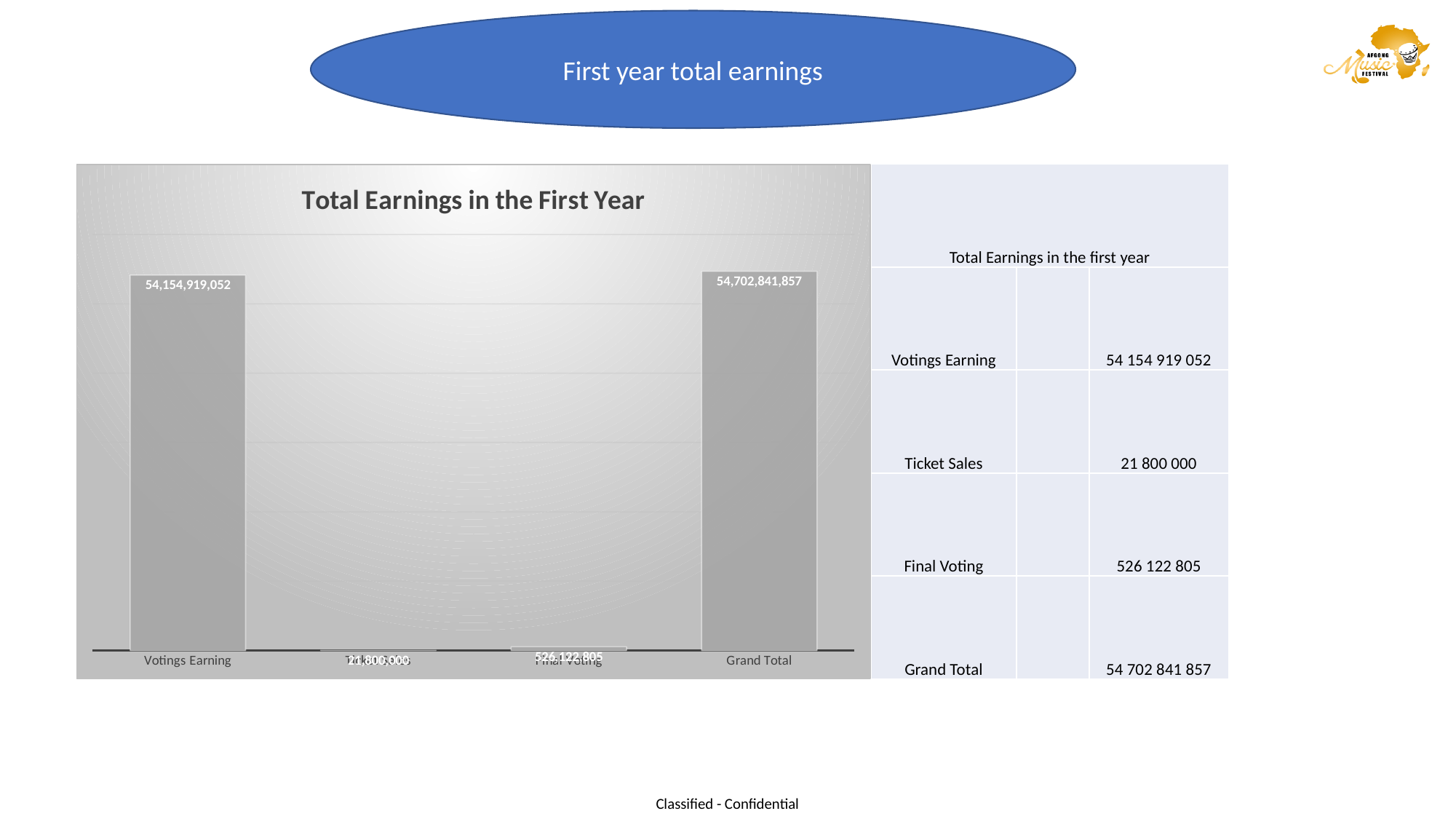
Which is larger in the Total Earnings in the First Year chart, Grand Total or Votings Earning? Grand Total What is the difference between Votings Earning and Final Voting in the Total Earnings in the First Year chart? 53,628,796,247 Which is larger in the Total Earnings in the First Year chart, Votings Earning or Final Voting? Votings Earning What is the value for Grand Total in the Total Earnings in the First Year chart? 54,702,841,857 What is the title of the chart on the slide? Total Earnings in the First Year How many categories are shown on the x axis of the Total Earnings in the First Year chart? 4 What is the value for Votings Earning in the Total Earnings in the First Year chart? 54,154,919,052 What is the value for Final Voting in the Total Earnings in the First Year chart? 526,122,805 Which category has the highest value in the Total Earnings in the First Year chart? Grand Total What is the difference between Grand Total and Votings Earning in the Total Earnings in the First Year chart? 547,922,805 What is the label of the first category on the x axis of the Total Earnings in the First Year chart? Votings Earning What kind of chart is the Total Earnings in the First Year chart? Bar chart